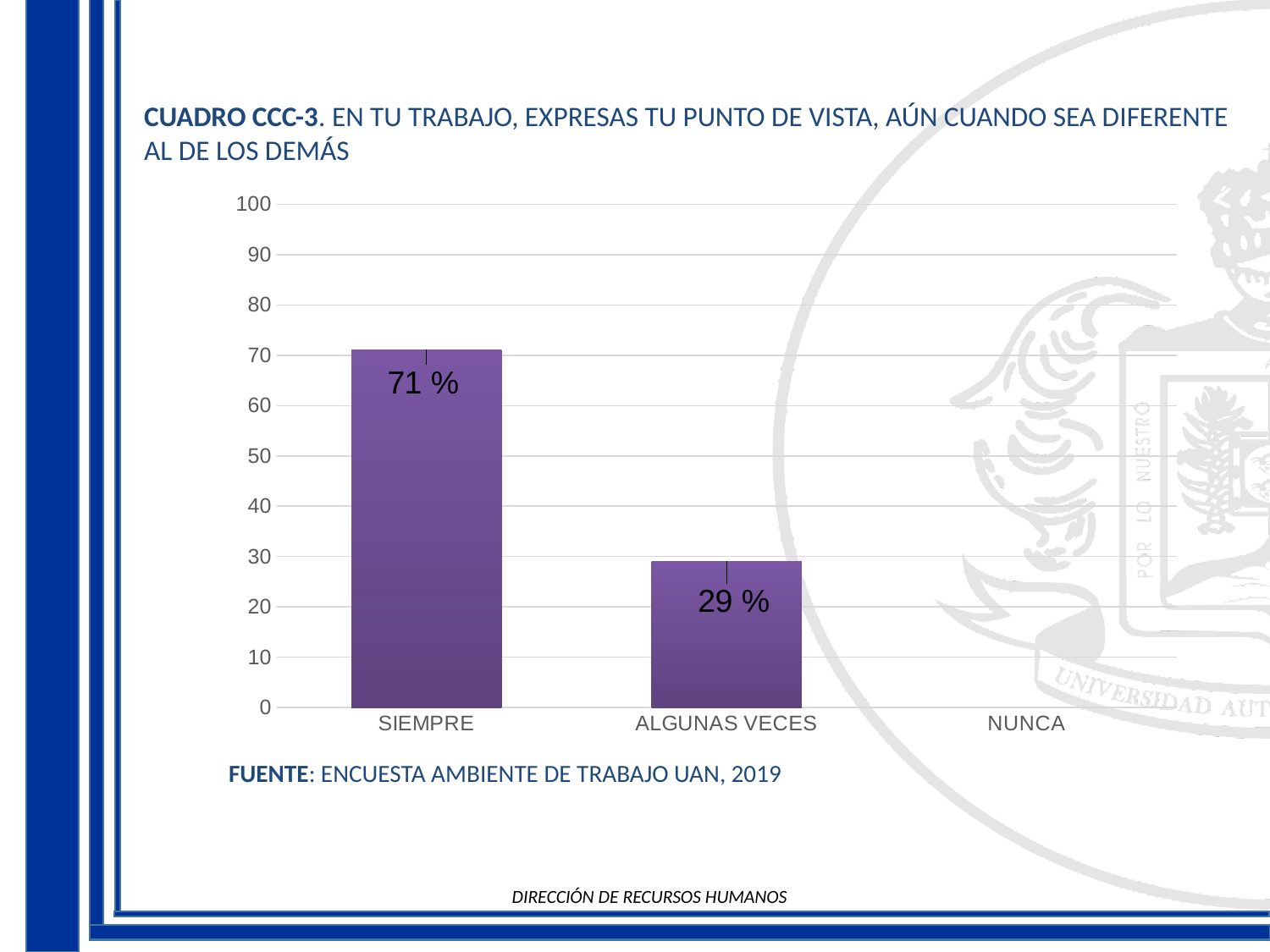
What is the difference between the values for SIEMPRE and ALGUNAS VECES? 42 % Is the value for SIEMPRE greater or less than 60? greater Which category has the highest value? SIEMPRE How many categories are shown on the x axis? 3 Is the value for ALGUNAS VECES greater or less than 40? less Which is larger, the value for SIEMPRE or the value for ALGUNAS VECES? SIEMPRE Do the values rise or fall from left to right along the x axis? fall What kind of chart is shown on the slide? bar chart What source is cited below the chart? ENCUESTA AMBIENTE DE TRABAJO UAN, 2019 What is the value for SIEMPRE? 71 % What is the value for ALGUNAS VECES? 29 %